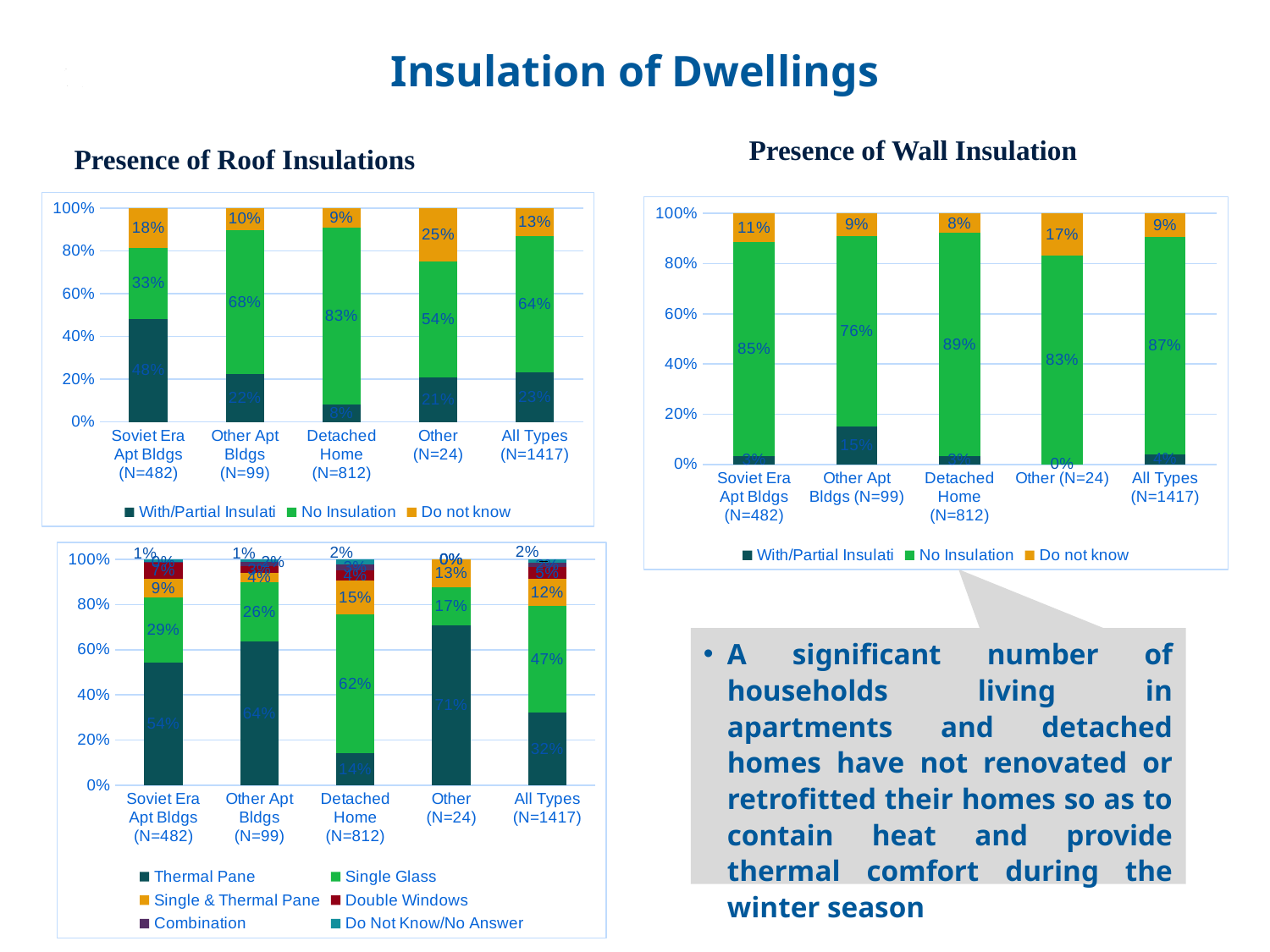
In the Presence of Roof Insulations chart, what percentage of Soviet Era Apt Bldgs (N=482) have With/Partial Insulation? 48% How many series does the legend of the bottom-left chart list? 6 In the Presence of Wall Insulation chart, is the No Insulation value for Other Apt Bldgs (N=99) larger or smaller than that for All Types (N=1417)? smaller In the Presence of Wall Insulation chart, what is the Do not know value for Other (N=24)? 17% In the Presence of Wall Insulation chart, which category has the lowest No Insulation value? Other Apt Bldgs (N=99) In the Presence of Wall Insulation chart, what is the No Insulation value for Detached Home (N=812)? 89% What kind of chart is the Presence of Wall Insulation chart? Stacked bar chart In the bottom-left chart, what is the Thermal Pane value for Other (N=24)? 71% In the bottom-left chart, what is the Single Glass value for Detached Home (N=812)? 62% In the Presence of Roof Insulations chart, what is the No Insulation value for Detached Home (N=812)? 83% In the Presence of Roof Insulations chart, which category has the highest Do not know value? Other (N=24) In the Presence of Roof Insulations chart, what is the difference between the No Insulation values for Other Apt Bldgs (N=99) and Soviet Era Apt Bldgs (N=482)? 35%